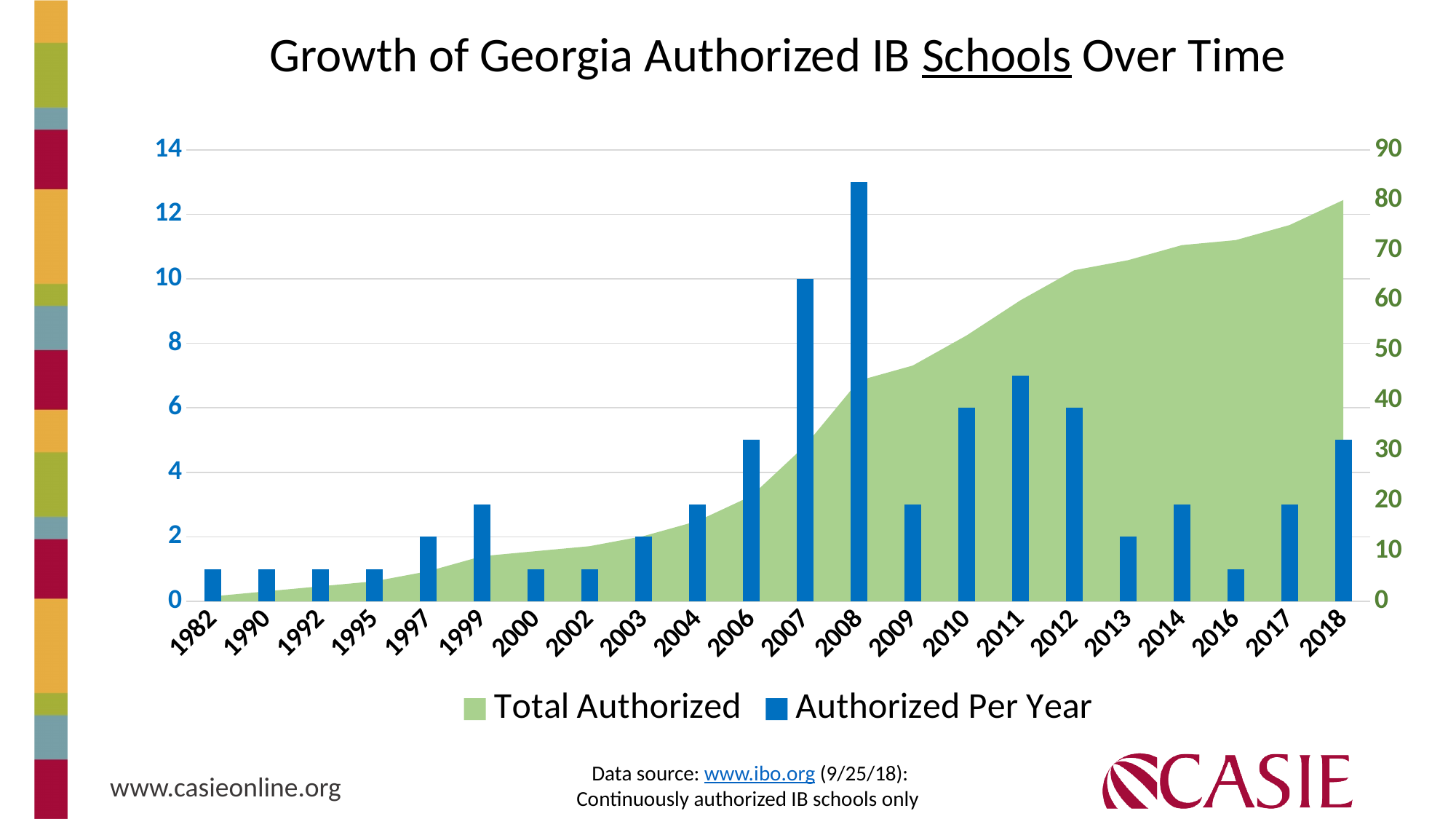
How many series does the legend list? 2 Is the Authorized Per Year value for 2011 greater or less than 8? less What is the Authorized Per Year value for 1997? 2 Which year has the highest value for Authorized Per Year? 2008 Is the Total Authorized value for 2018 greater or less than 70? greater What kind of chart is shown on the slide? A combination bar and area chart What is the Authorized Per Year value for 2010? 6 Does the Total Authorized series rise or fall over time along the x axis? Rises Which is larger, the Authorized Per Year value for 2007 or for 2011? 2007 Is the Authorized Per Year value for 2008 greater or less than 12? greater How many years are shown along the x axis? 22 What is the Authorized Per Year value for 2007? 10